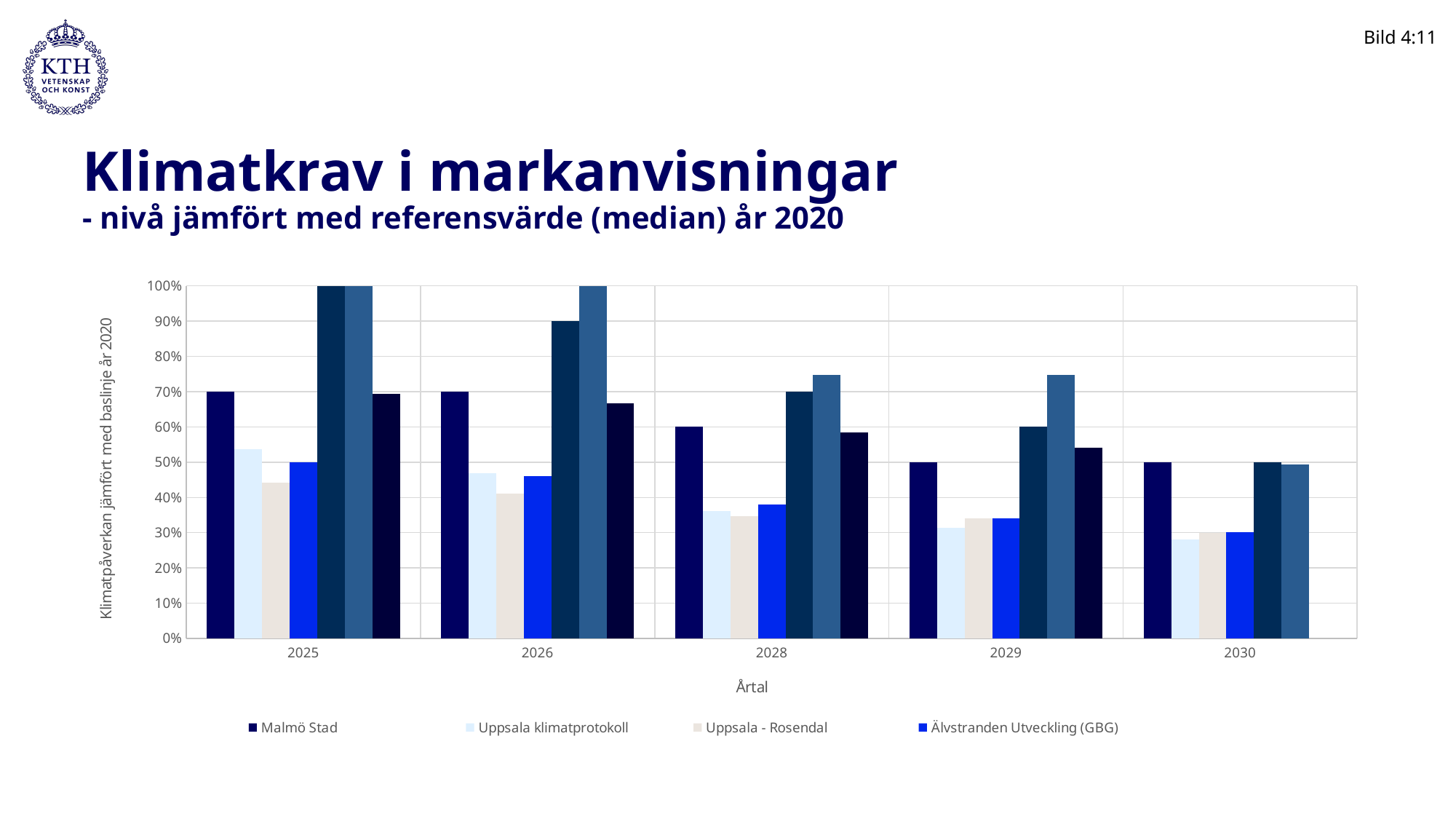
Is the value for Uppsala klimatprotokoll in 2026 greater or less than 40%? greater What is the difference between the Malmö Stad values for 2025 and 2030? 20% In 2028, which is larger: Malmö Stad or Uppsala - Rosendal? Malmö Stad What is the value for Älvstranden Utveckling (GBG) in 2025? 50% What is the title of the x axis? Årtal How many series does the legend list? 4 How many years are shown on the x axis? 5 What kind of chart is shown on the slide? bar chart Do the values for Malmö Stad rise or fall from 2025 to 2030? fall What is the value for Malmö Stad in 2025? 70% What is the value for Malmö Stad in 2030? 50% Is the value for Uppsala klimatprotokoll in 2025 greater or less than 60%? less